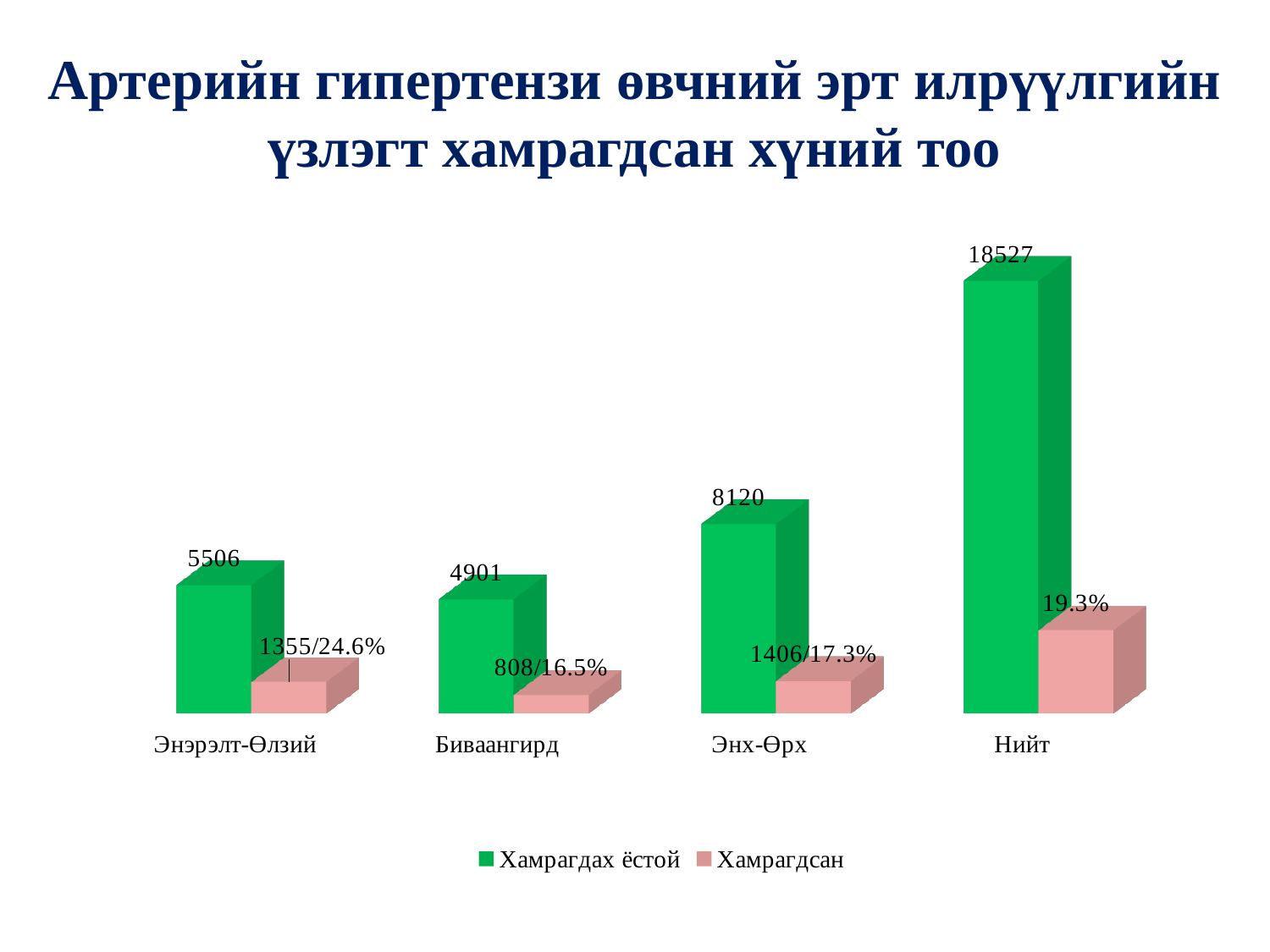
What is the value of Хамрагдах ёстой for Энх-Өрх? 8120 How many categories are shown on the x axis? 4 What data label is shown for Хамрагдсан at Нийт? 19.3% What is the value of Хамрагдах ёстой for Нийт? 18527 What data label is shown for Хамрагдсан at Биваангирд? 808/16.5% What is the difference between the Хамрагдах ёстой values for Энх-Өрх and Энэрэлт-Өлзий? 2614 Which category has the lowest Хамрагдах ёстой value? Биваангирд Which is larger, the Хамрагдах ёстой value for Энэрэлт-Өлзий or for Биваангирд? Энэрэлт-Өлзий What is the value of Хамрагдах ёстой for Биваангирд? 4901 How many series does the legend list? 2 Which category has the highest Хамрагдах ёстой value? Нийт What data label is shown for Хамрагдсан at Энэрэлт-Өлзий? 1355/24.6%